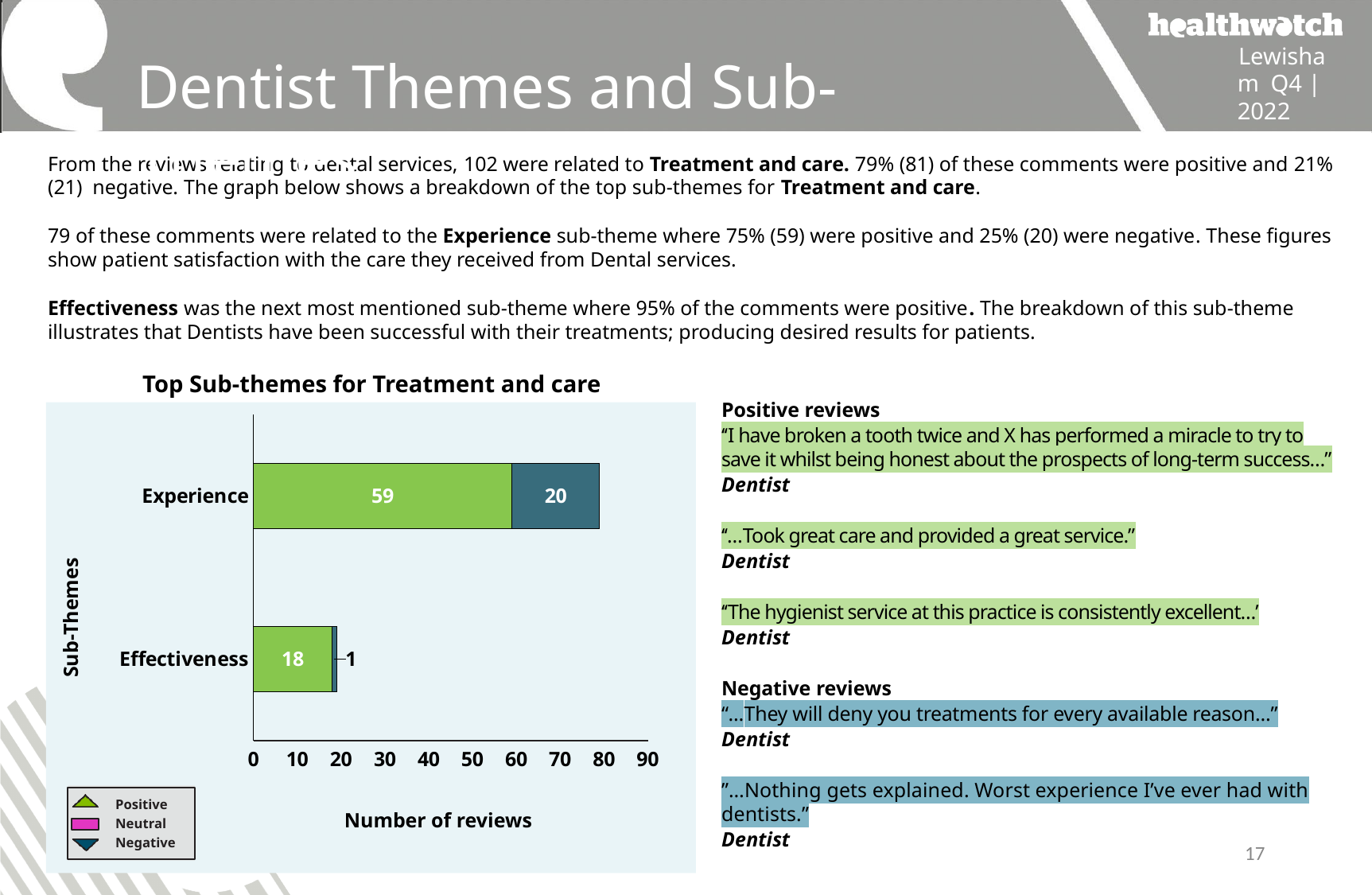
What is the Positive value for Effectiveness in the chart? 18 What is the total number of reviews for the Experience bar? 79 Which sub-theme has the highest Positive value? Experience What is the Negative value for Experience in the chart? 20 What is the Negative value for Effectiveness in the chart? 1 What type of chart is used to show the top sub-themes for Treatment and care? Stacked bar chart How many series does the chart legend list? 3 Which sub-theme has the higher Negative value, Experience or Effectiveness? Experience What is the total number of reviews for the Effectiveness bar? 19 What is the Positive value for Experience in the Top Sub-themes for Treatment and care chart? 59 What is the difference between the Positive values for Experience and Effectiveness? 41 How many sub-themes are shown in the chart? 2